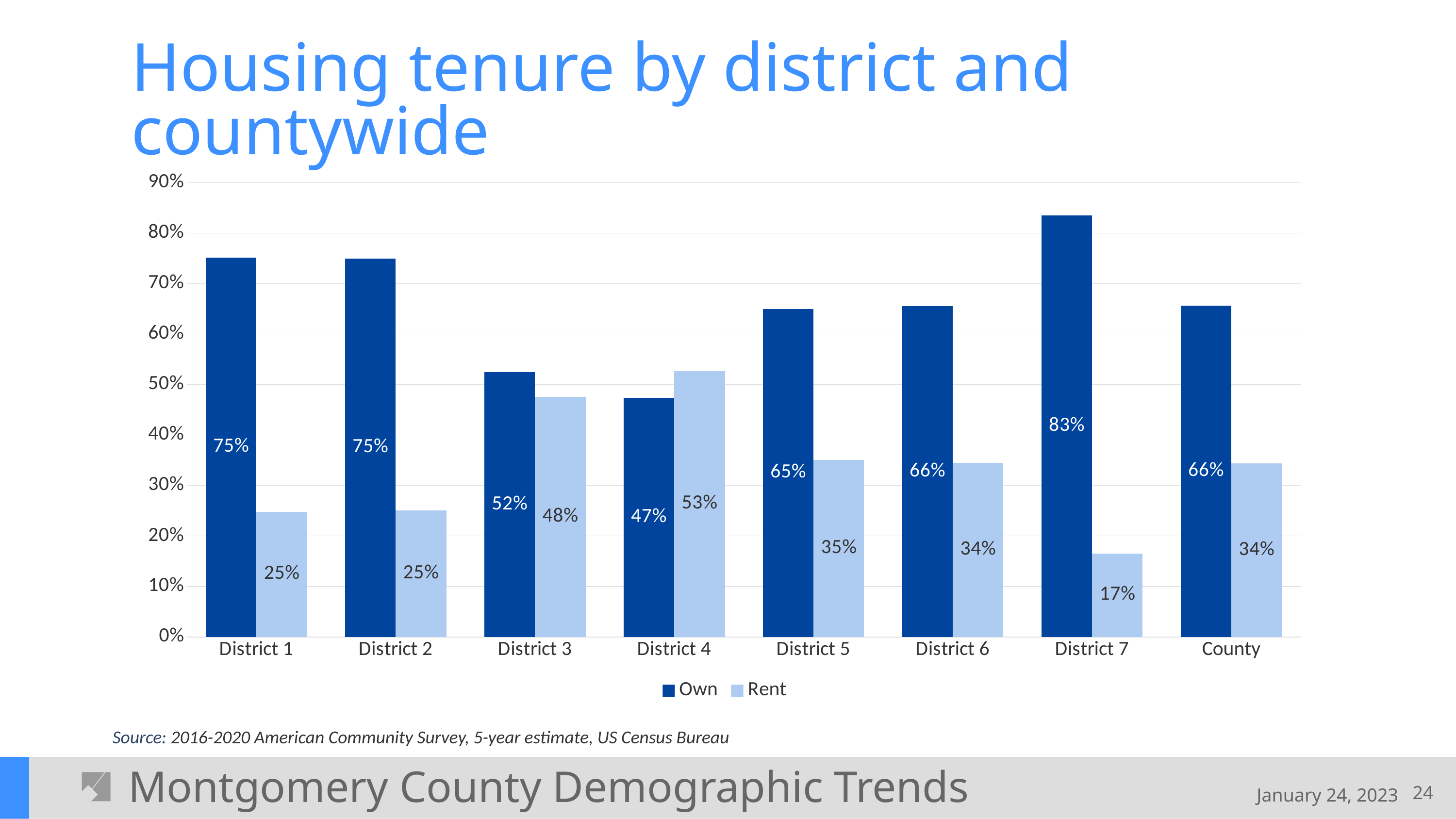
What is the Own value for District 7? 83% What is the Rent value for District 4? 53% What is the title of the chart on the slide? Housing tenure by district and countywide Which is larger for District 4, the Own value or the Rent value? Rent Is the Rent value for District 3 greater or less than 40%? greater Which category has the highest Own value? District 7 How many categories are shown on the x axis? 8 Which category has the lowest Rent value? District 7 What kind of chart is shown on the slide? bar chart What is the Own value for County? 66% What is the difference between the Own and Rent values for District 5? 30% How many series does the legend list? 2